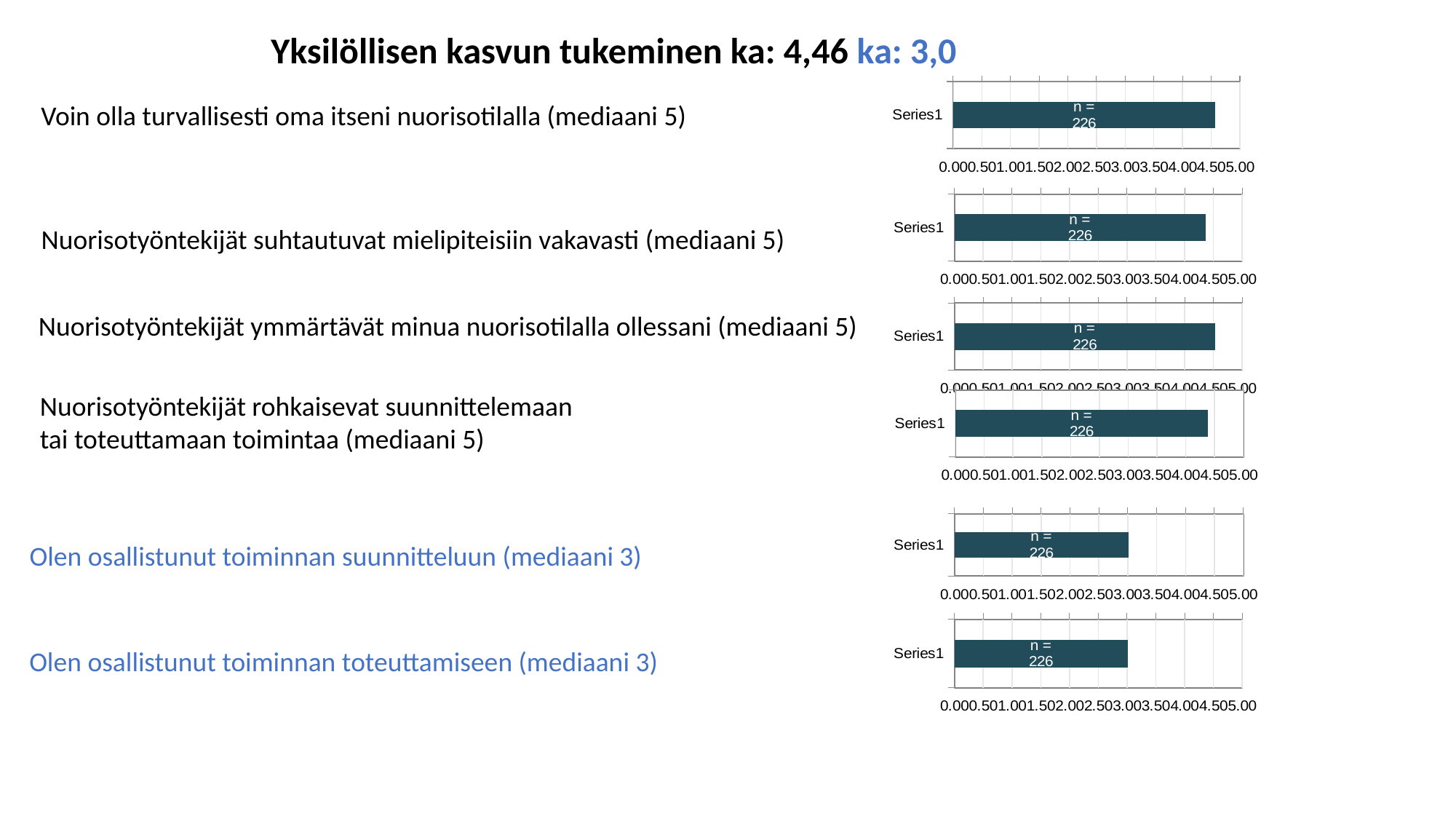
What data label is printed on the bar in the top chart? n = 226 Which is larger: the Series1 value in the top chart or the Series1 value in the bottom chart? the top chart What is the maximum value shown on the x axis of the bottom chart? 5.00 In the top chart, is the value for Series1 greater or less than 4.00? greater In the bottom chart, is the value for Series1 greater or less than 2.50? greater How many bars does the top chart contain? 1 In the bottom chart, is the value for Series1 greater or less than 3.50? less How many bar charts are shown on the slide? 6 What kind of chart is the top chart on the slide? bar chart